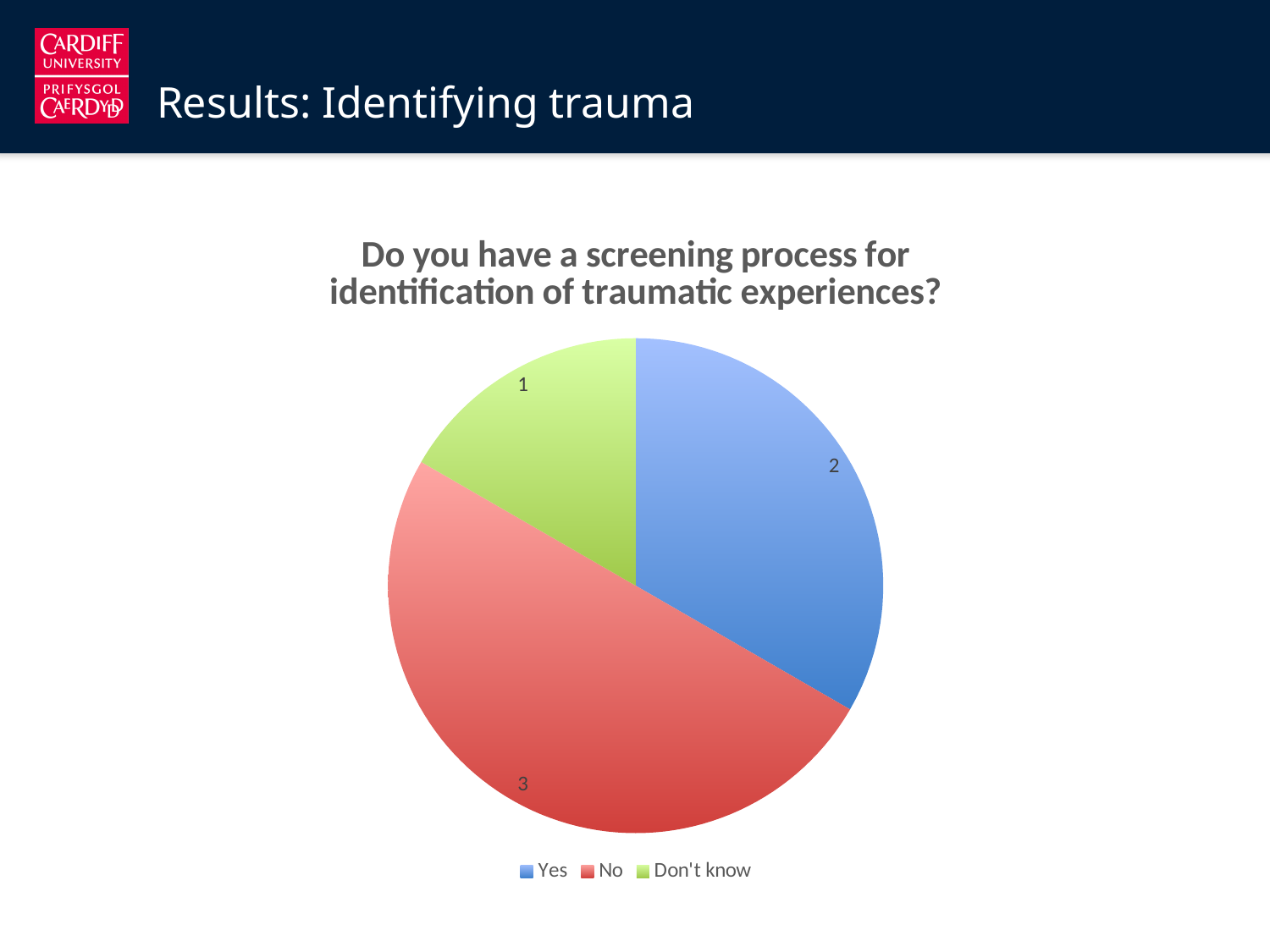
What is the value for "No"? 3 What type of chart is shown on the slide? pie chart What is the value for "Yes"? 2 What colour is the "Yes" slice? blue How many categories does the pie chart show? 3 Which category has the largest slice? No Which is larger, the value for "Yes" or the value for "Don't know"? Yes What is the value for "Don't know"? 1 What is the difference between the values for "No" and "Yes"? 1 Which category has the smallest slice? Don't know What is the title of the chart? Do you have a screening process for identification of traumatic experiences? What share of the pie does the "No" slice represent? 50%